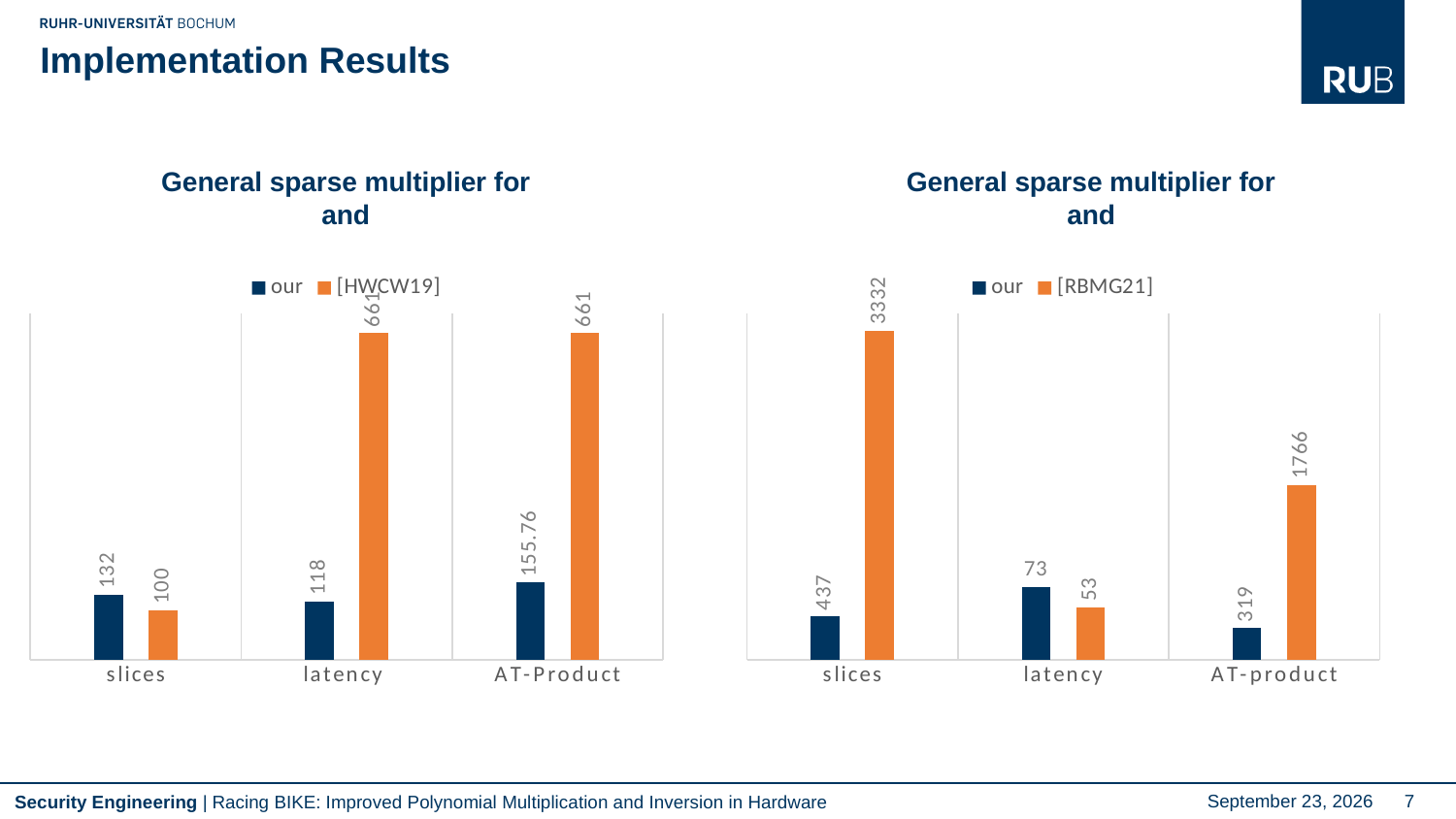
What type of chart is the left chart? Bar chart In the left chart, what is the difference between the [HWCW19] and 'our' values for slices? 32 In the right chart, what is the value of [RBMG21] for AT-product? 1766 In the right chart, what is the value of the 'our' series for latency? 73 How many series does the legend of the right chart list? 2 In the left chart, what is the value of the 'our' series for AT-Product? 155.76 In the left chart, what is the value of the 'our' series for slices? 132 In the left chart, what is the value of [HWCW19] for latency? 661 In the right chart, what is the value of [RBMG21] for slices? 3332 In the right chart, what is the difference between the [RBMG21] and 'our' values for AT-product? 1447 In the left chart, which series has the larger value for latency, 'our' or [HWCW19]? [HWCW19]